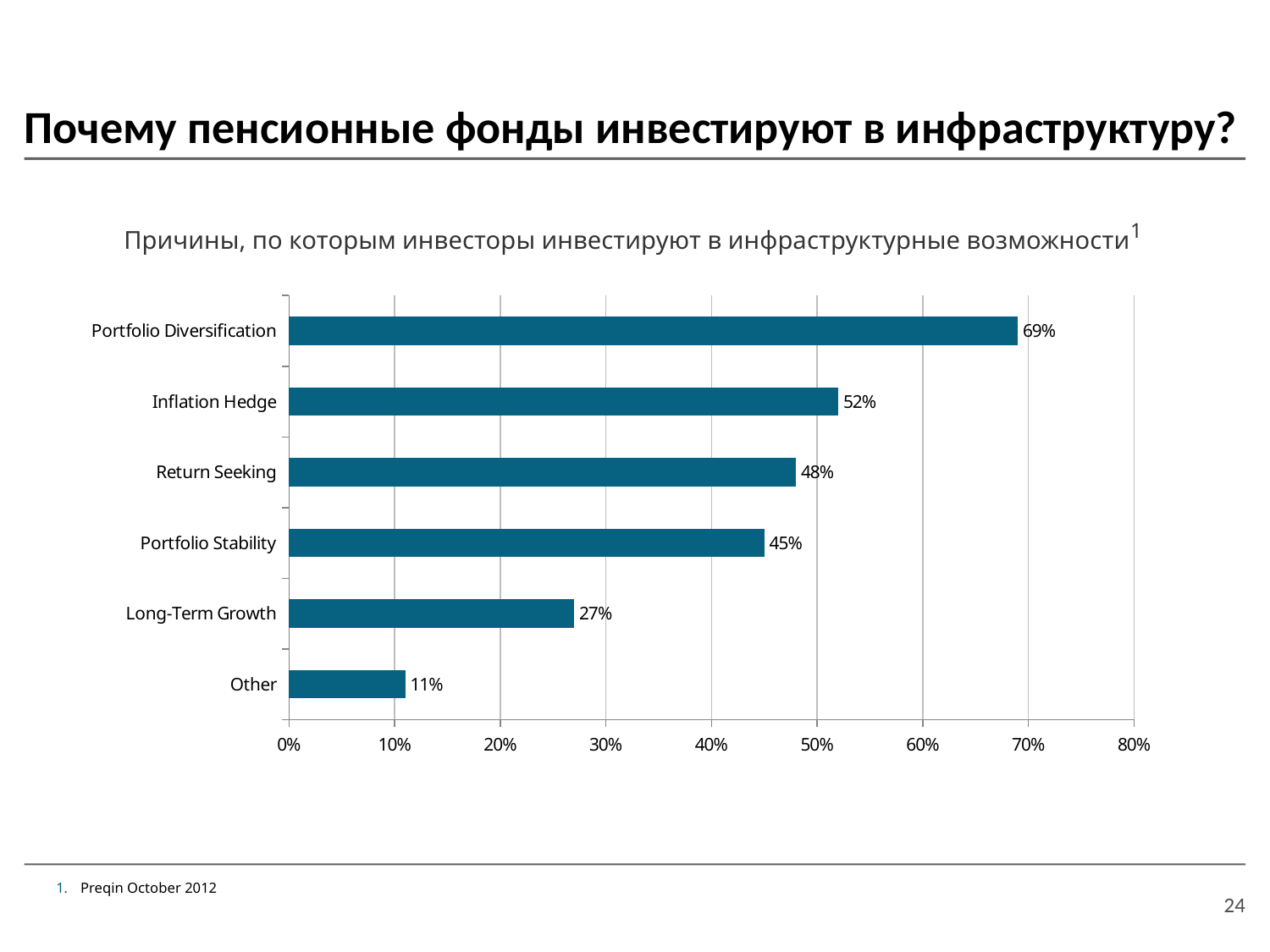
What is the value for Other? 11% What is the maximum value shown on the x axis? 80% Which category has the highest value? Portfolio Diversification What is the value for Long-Term Growth? 27% Is the value for Portfolio Stability greater or less than 40%? greater What is the value for Portfolio Diversification? 69% How many categories are shown in the chart? 6 What is the difference between the values for Portfolio Diversification and Inflation Hedge? 17% Which is larger, the value for Return Seeking or the value for Portfolio Stability? Return Seeking What kind of chart is shown on the slide? Bar chart Which category has the lowest value? Other What is the value for Inflation Hedge? 52%